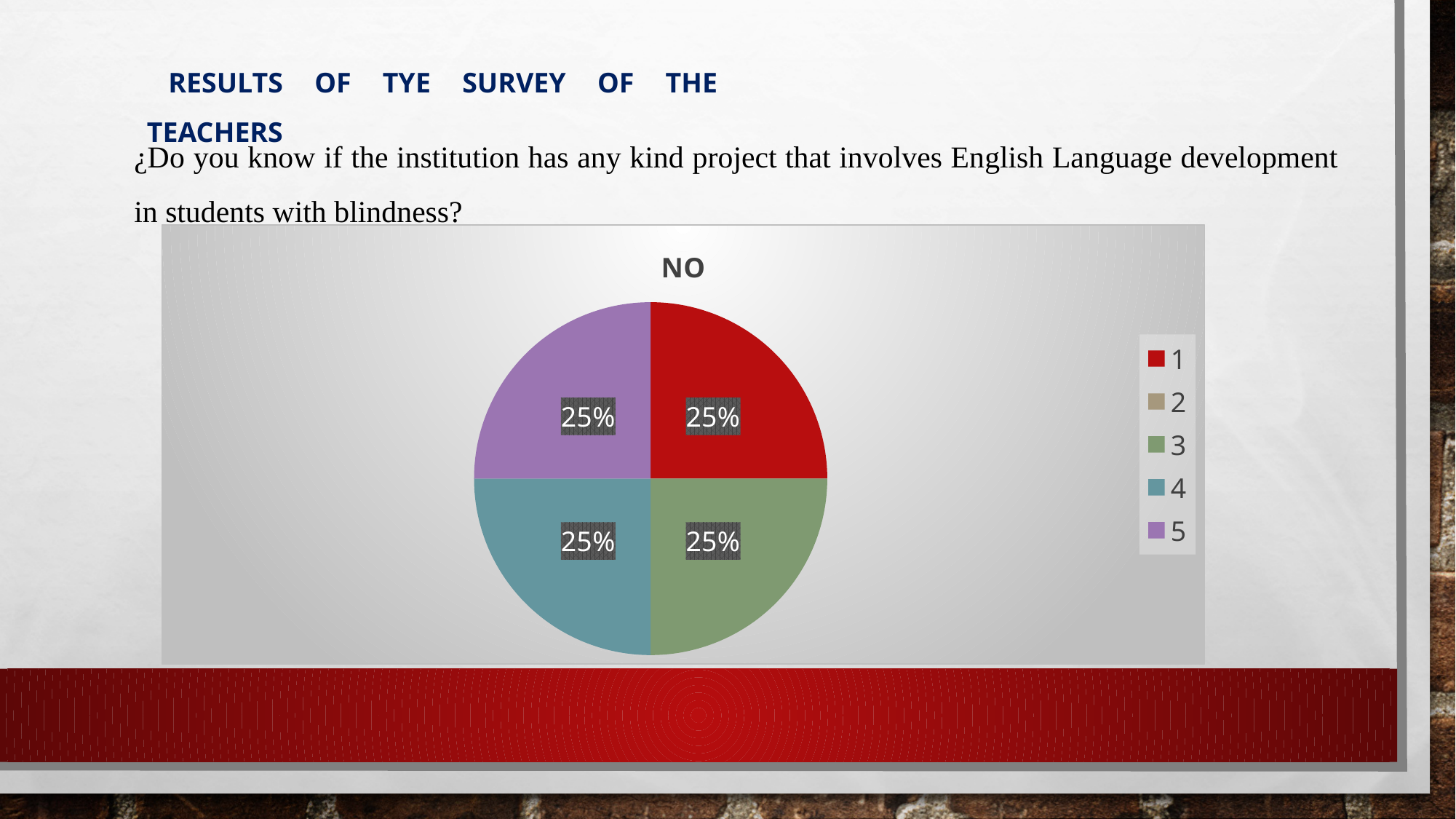
How many entries does the chart's legend list? 5 What is the difference between the share of slice 1 and the share of slice 4? 0% What share of the pie does slice 5 (purple) represent? 25% What kind of chart is shown on the slide? pie chart What is the title of the chart? NO How many slices are visible in the pie chart? 4 What share of the pie does slice 3 (green) represent? 25% What share of the pie does slice 1 (red) represent? 25% Is the share of slice 1 greater or less than 50%? less Which legend entry has no visible slice in the pie? 2